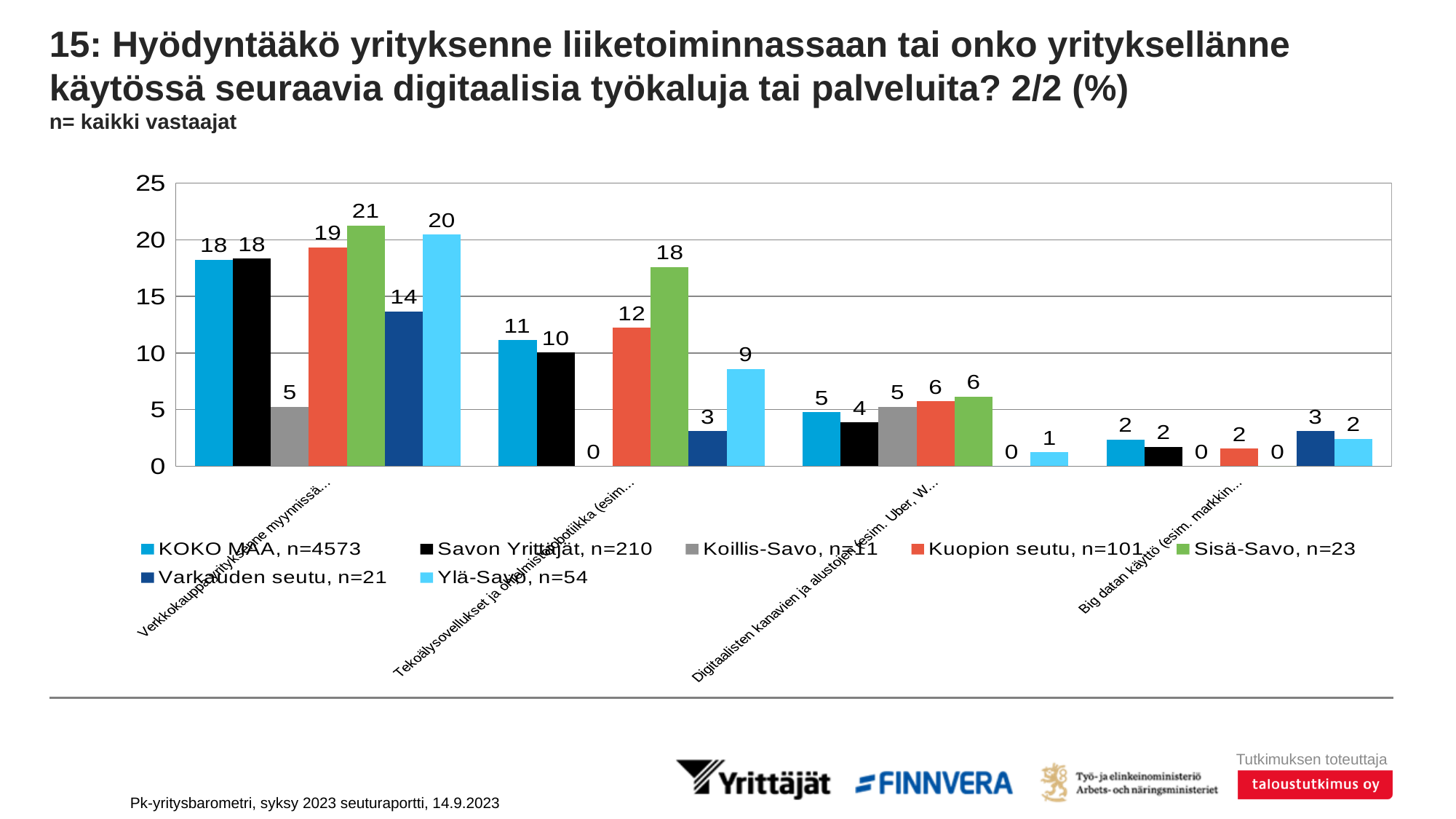
How many category groups are plotted along the x axis? 4 What is the value for Ylä-Savo in the third category group (Digitaalisten kanavien...)? 1 In the second category group (Tekoälysovellukset...), what is the difference between the Sisä-Savo value and the Varkauden seutu value? 15 What is the value for Varkauden seutu in the last category group (Big datan käyttö...)? 3 Do the KOKO MAA values rise or fall from the first category group to the last? fall What is the value for Sisä-Savo in the first category group (Verkkokauppa...)? 21 What kind of chart is shown on the slide? bar chart Which series has the highest value in the first category group (Verkkokauppa...)? Sisä-Savo, n=23 How many series does the legend list? 7 Which series has the lowest value in the second category group (Tekoälysovellukset...)? Koillis-Savo, n=11 According to the legend, what is the n for Kuopion seutu? 101 In the second category group (Tekoälysovellukset...), which is larger: the KOKO MAA value or the Savon Yrittäjät value? KOKO MAA